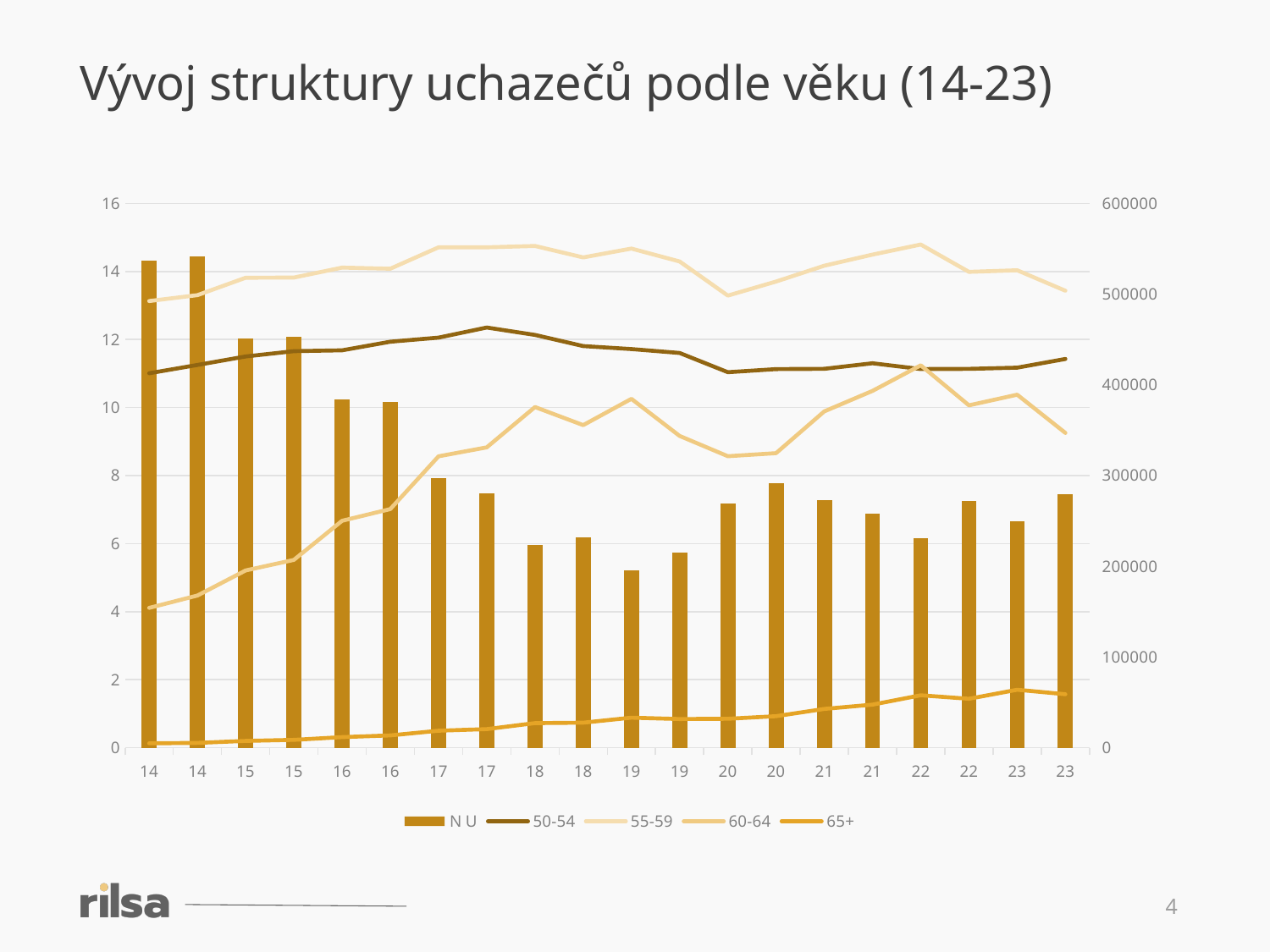
What kind of chart is this? Combined bar and line chart Which line series has the lowest values across the chart? 65+ How many bars are plotted in the chart? 20 Which series is drawn as bars? N U Is the value of the first N U bar labelled 14 greater or less than 12? greater Is the value of the 65+ line at the last point (23) greater or less than 100000? less How many series does the legend list? 5 Which line series has the highest values across the chart? 55-59 What is the title of the chart? Vývoj struktury uchazečů podle věku (14-23) Does the 65+ line rise or fall along the x axis from 14 to 23? rise